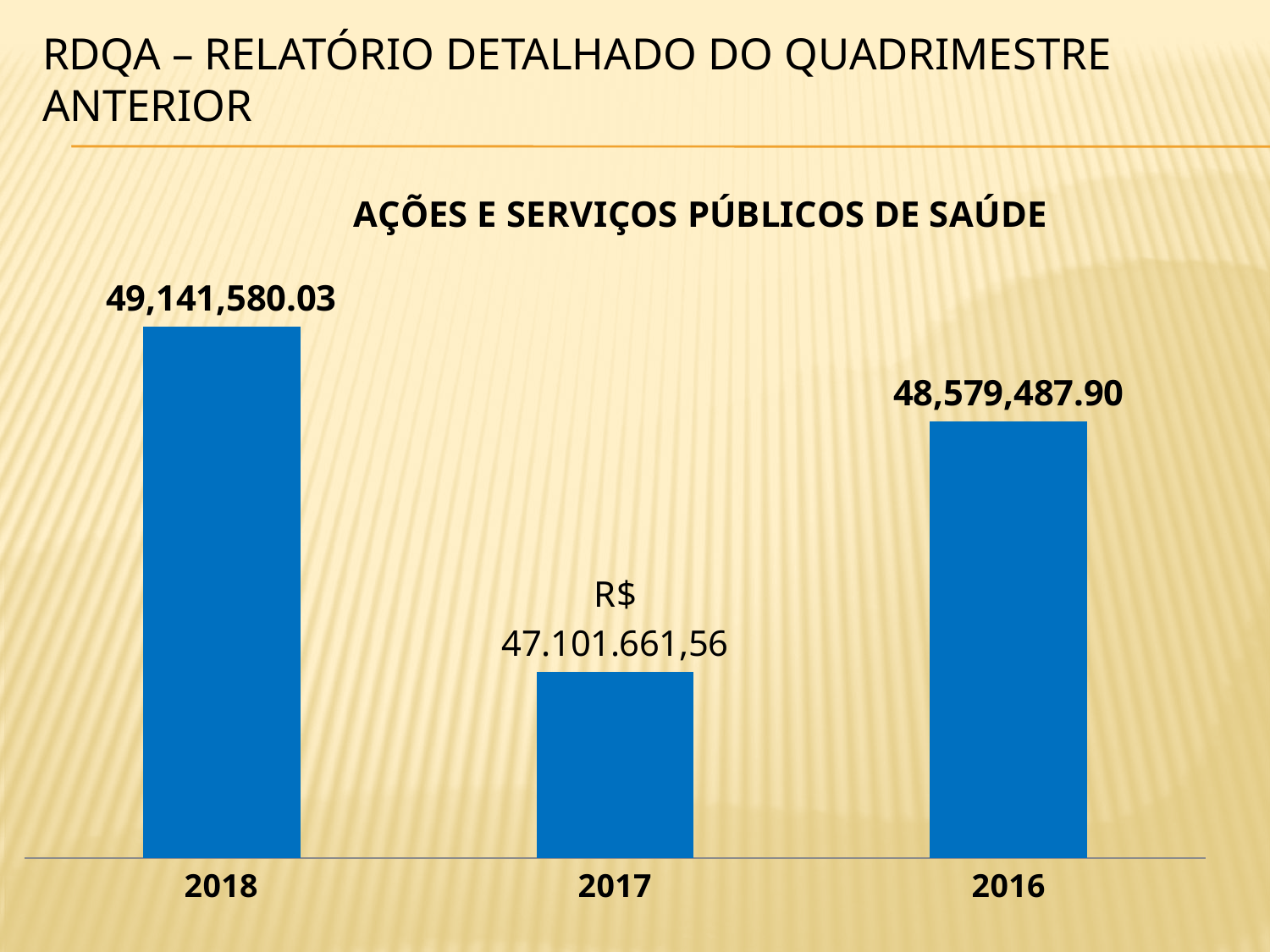
Which is larger, the value for 2016 or the value for 2017? 2016 What is the title of the chart? AÇÕES E SERVIÇOS PÚBLICOS DE SAÚDE How many bars (years) are shown in the chart? 3 What is the value shown for 2016? 48,579,487.90 What is the value shown for 2018? 49,141,580.03 Which year has the highest value? 2018 Do the values rise or fall from the 2018 bar to the 2017 bar? fall What type of chart is shown on the slide? bar chart What colour are the bars in the chart? blue What is the value shown for 2017? R$ 47.101.661,56 Which year has the lowest value? 2017 What is the difference between the values for 2018 and 2016? 562,092.13